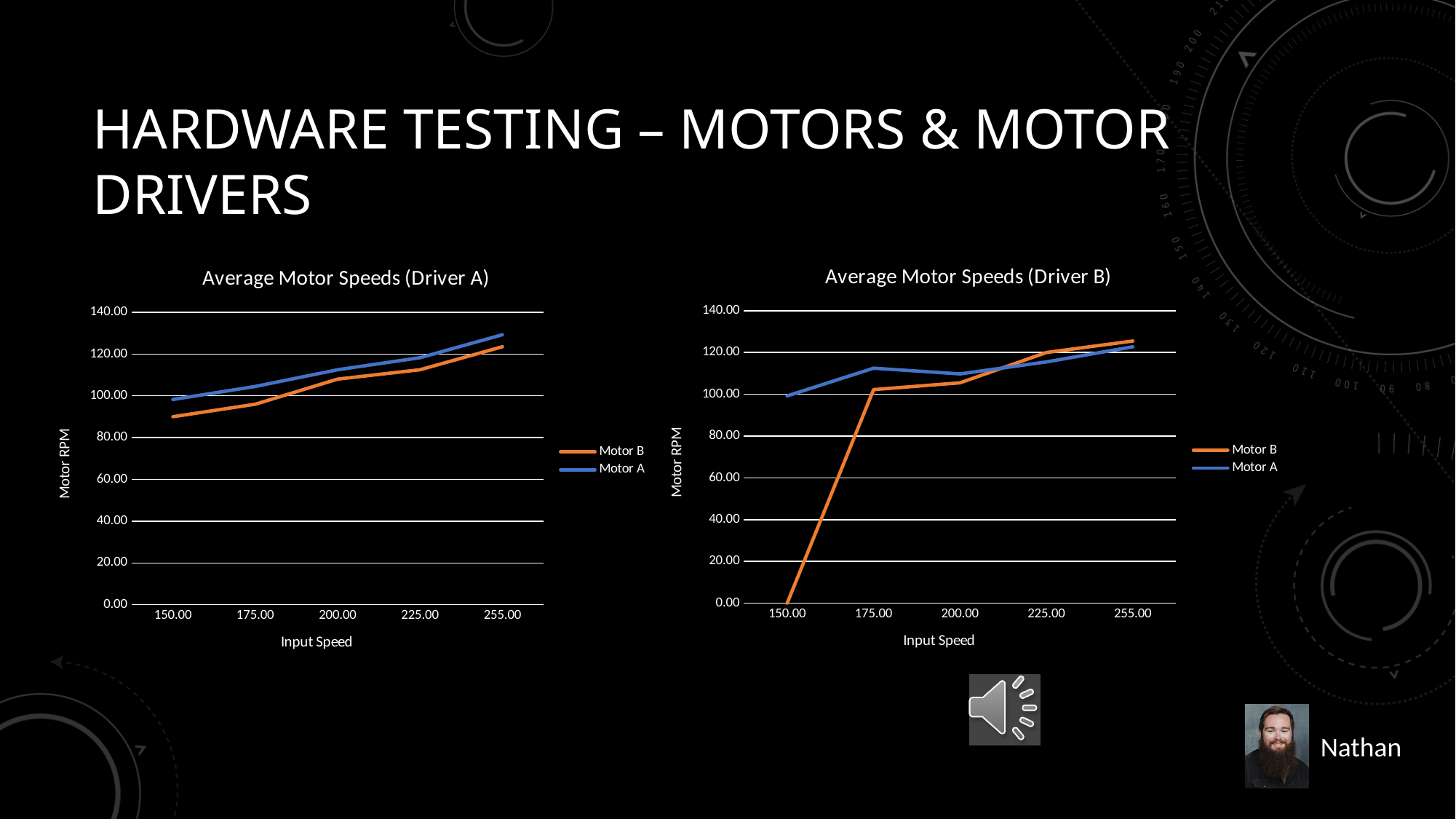
What is the x-axis title of "Average Motor Speeds (Driver A)"? Input Speed In "Average Motor Speeds (Driver A)", is the Motor B value at input speed 150.00 greater or less than 100? less What is the y-axis title of "Average Motor Speeds (Driver B)"? Motor RPM What kind of chart is "Average Motor Speeds (Driver A)"? line chart In "Average Motor Speeds (Driver A)", do the Motor A values rise or fall as input speed increases? rise In "Average Motor Speeds (Driver B)", is the Motor B value at input speed 150.00 greater or less than 20? less In "Average Motor Speeds (Driver A)", is the Motor A value at input speed 255.00 greater or less than 120? greater In "Average Motor Speeds (Driver A)", which series has the higher value at input speed 150.00, Motor A or Motor B? Motor A How many series does the legend of "Average Motor Speeds (Driver B)" list? 2 How many input speed values are plotted along the x axis of "Average Motor Speeds (Driver A)"? 5 In "Average Motor Speeds (Driver B)", which series has the higher value at input speed 150.00, Motor A or Motor B? Motor A